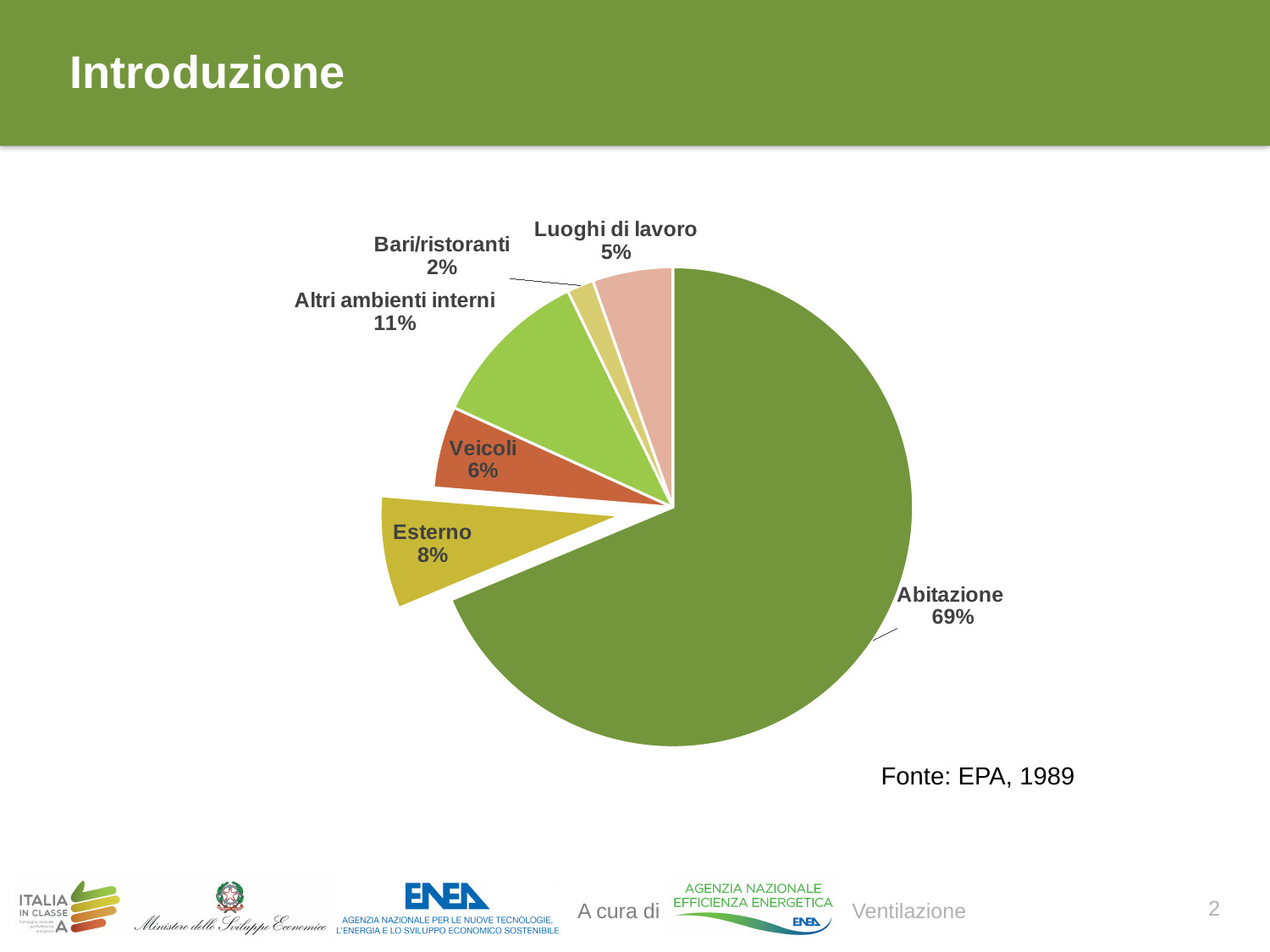
Which category has the largest slice? Abitazione What is the value for Luoghi di lavoro? 5% Which is larger, Esterno or Veicoli? Esterno What is the difference between Abitazione and Altri ambienti interni? 58% What share of the pie does Abitazione represent? 69% Which category has the smallest slice? Bari/ristoranti How many slices does the pie chart have? 6 What is the value for Altri ambienti interni? 11% What is the value for Veicoli? 6% What kind of chart is shown on the slide? pie chart What is the value for Esterno? 8% What source is cited below the chart? Fonte: EPA, 1989